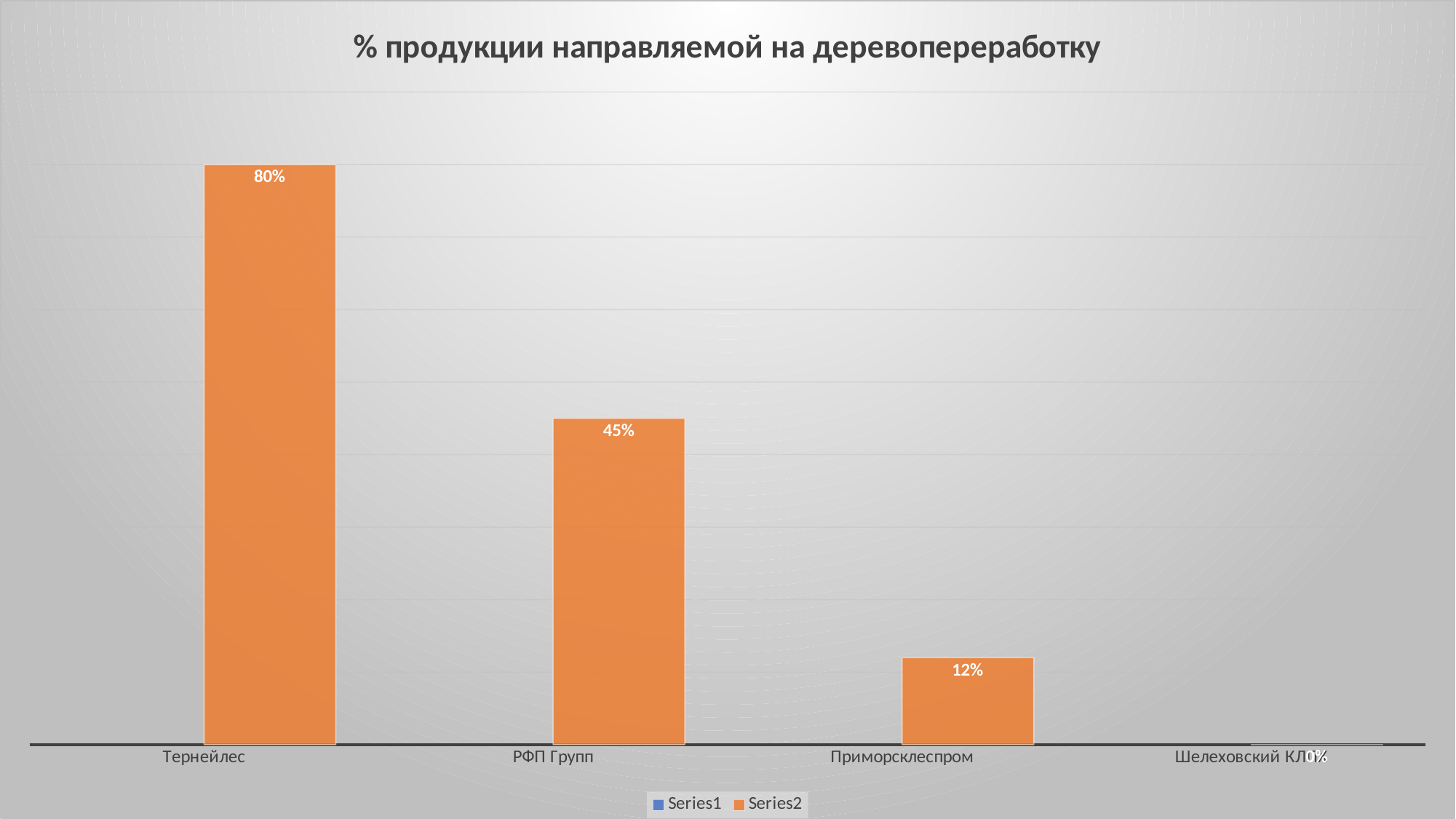
What is the value shown for the rightmost category on the chart? 0% What is the difference between the values for Тернейлес and РФП Групп? 35% What is the title of the chart? % продукции направляемой на деревопереработку What is the value for Тернейлес? 80% How many categories are shown on the x axis? 4 What type of chart is shown on the slide? bar chart Which is larger, the value for РФП Групп or the value for Приморсклеспром? РФП Групп What is the value for РФП Групп? 45% What is the value for Приморсклеспром? 12% What is the difference between the values for РФП Групп and Приморсклеспром? 33% Which category has the highest value? Тернейлес How many series does the legend list? 2